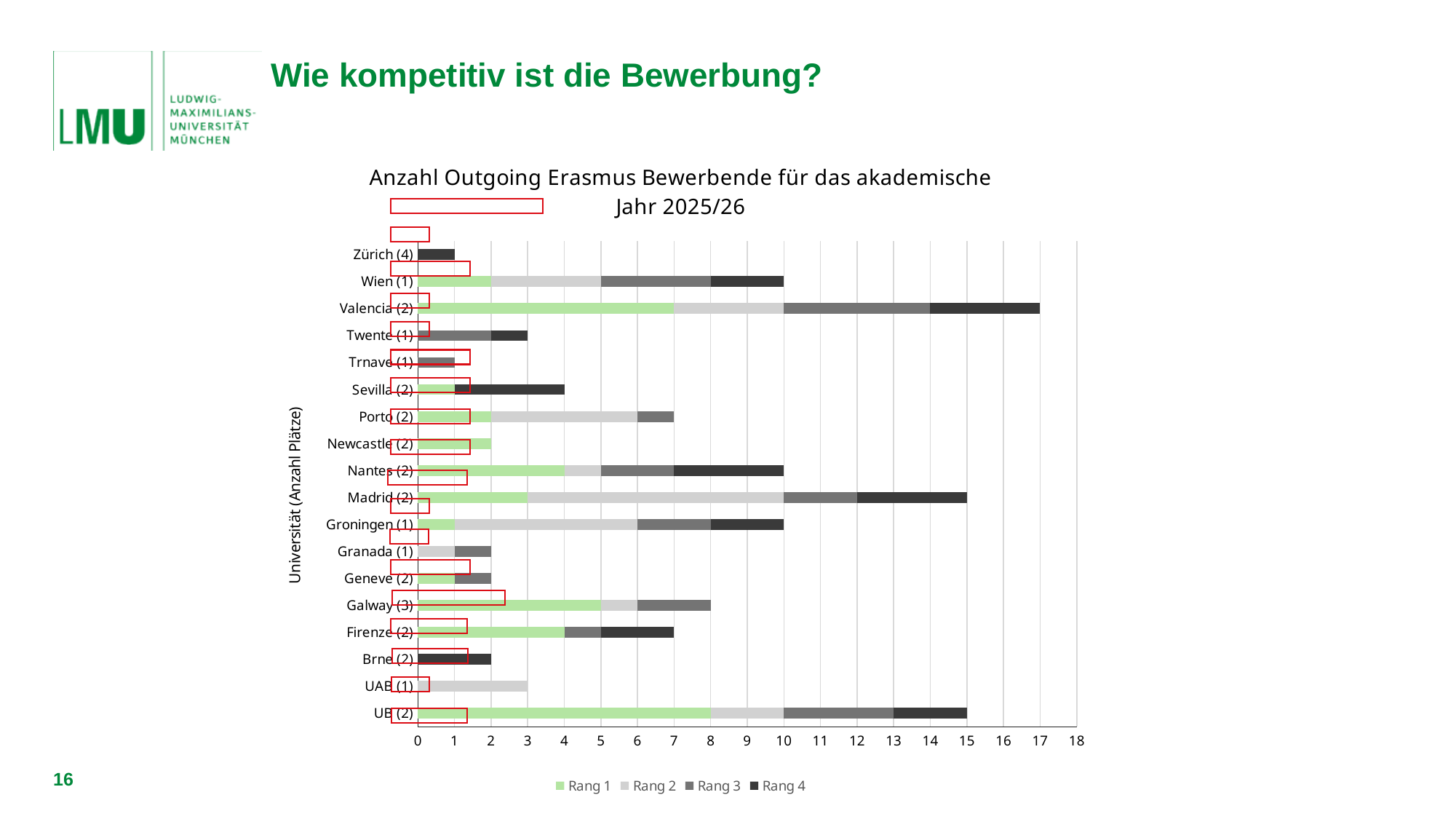
What is the total number of applicants for Madrid (2)? 15 What is the total number of applicants for Wien (1)? 10 Which university has the highest total number of applicants? Valencia (2) Which has more total applicants, Wien (1) or Galway (3)? Wien (1) What kind of chart is shown on the slide? Stacked bar chart How many Rang 1 applicants does Valencia (2) have? 7 How many universities are listed on the vertical axis? 18 What is the difference between the total applicants for Valencia (2) and Madrid (2)? 2 How many series does the legend list? 4 Is the total number of applicants for Valencia (2) greater or less than 15? greater What are the legend entries of the chart? Rang 1, Rang 2, Rang 3, Rang 4 How many Rang 1 applicants does UB (2) have? 8